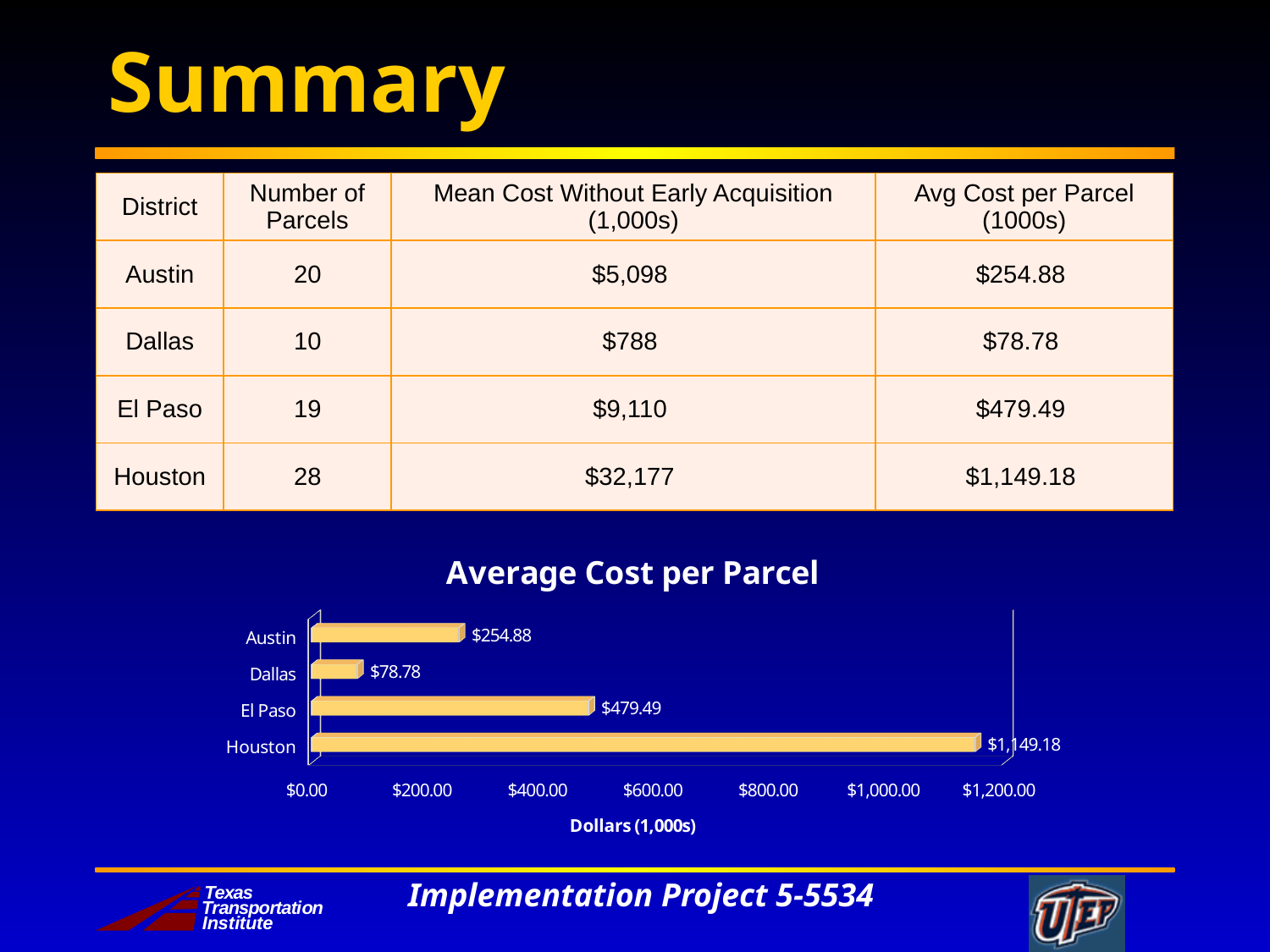
What is the average cost per parcel for Austin in the chart? $254.88 How many districts are shown in the chart? 4 Which district has the lowest average cost per parcel in the chart? Dallas Which district has the highest average cost per parcel in the chart? Houston Which has a larger average cost per parcel in the chart, Austin or El Paso? El Paso Is the value for Houston in the chart greater or less than $1,000.00? greater What kind of chart is shown on the slide? Bar chart What is the difference between the average cost per parcel for El Paso and Austin in the chart? $224.61 What is the title of the chart on the slide? Average Cost per Parcel What is the average cost per parcel for Houston in the chart? $1,149.18 What is the average cost per parcel for Dallas in the chart? $78.78 What is the average cost per parcel for El Paso in the chart? $479.49